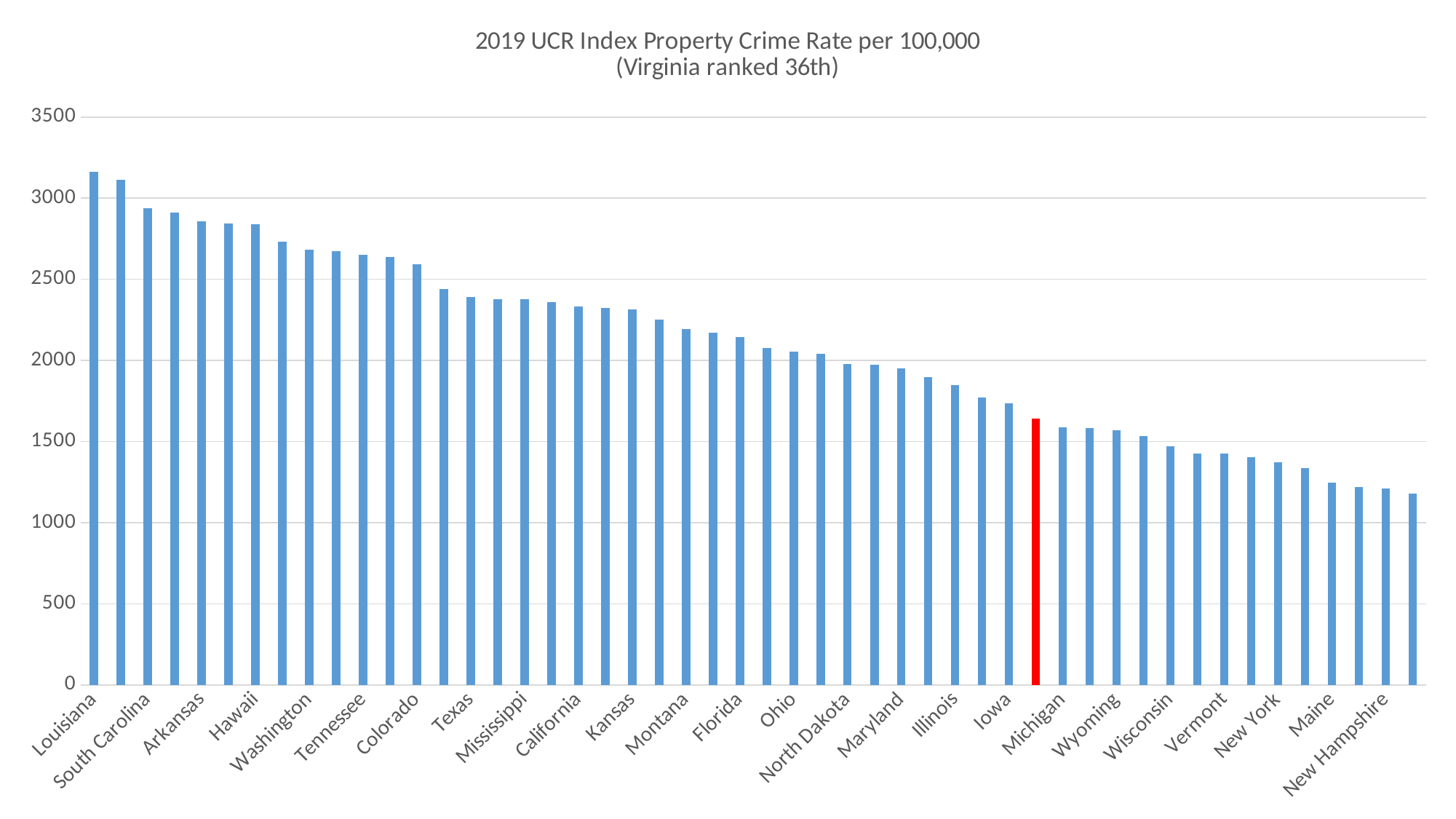
Is the value for New Hampshire greater or less than 1500? less Do the values rise or fall moving from left to right along the x axis? fall What kind of chart is shown on the slide? bar chart Which state has the highest property crime rate in the chart? Louisiana Which has the larger value, Maine or Hawaii? Hawaii Which has the larger value, Texas or Florida? Texas Is the value for Texas greater or less than 2000? greater Is the value for Louisiana greater or less than 3000? greater What is the title of the chart? 2019 UCR Index Property Crime Rate per 100,000 (Virginia ranked 36th) Which state does the red bar represent? Virginia